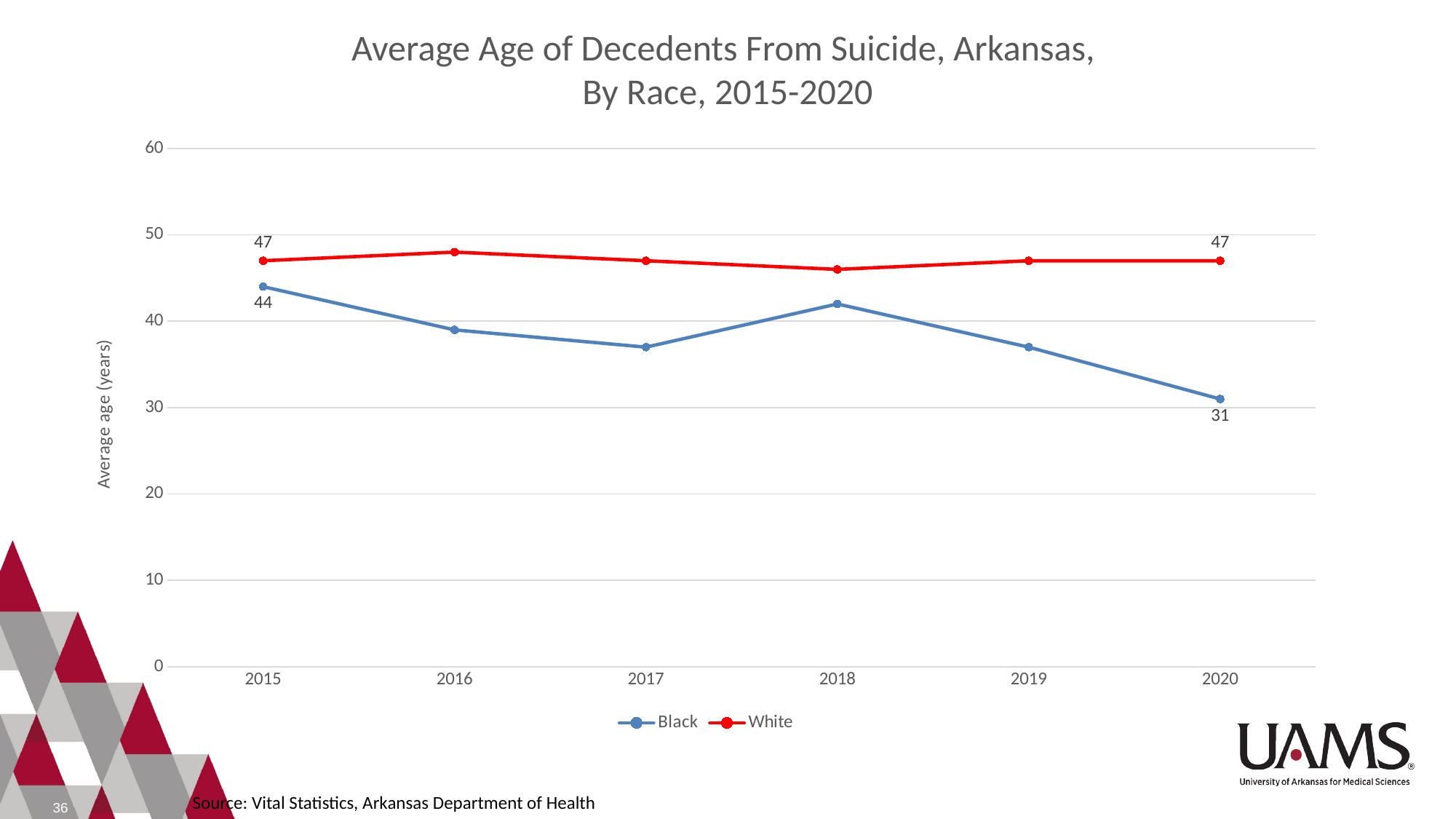
What is the average age of Black decedents in 2015? 44 What is the average age of White decedents in 2020? 47 Is the value for Black in 2018 greater or less than 40? greater What kind of chart is shown on the slide? line chart What is the average age of White decedents in 2015? 47 How many series does the legend list? 2 Is the value for White in 2018 greater or less than 50? less How many years are shown on the x axis? 6 By how much did the average age of Black decedents fall from 2015 to 2020? 13 In 2015, which group had the higher average age, Black or White? White What is the difference between the White and Black average ages in 2020? 16 What is the average age of Black decedents in 2020? 31